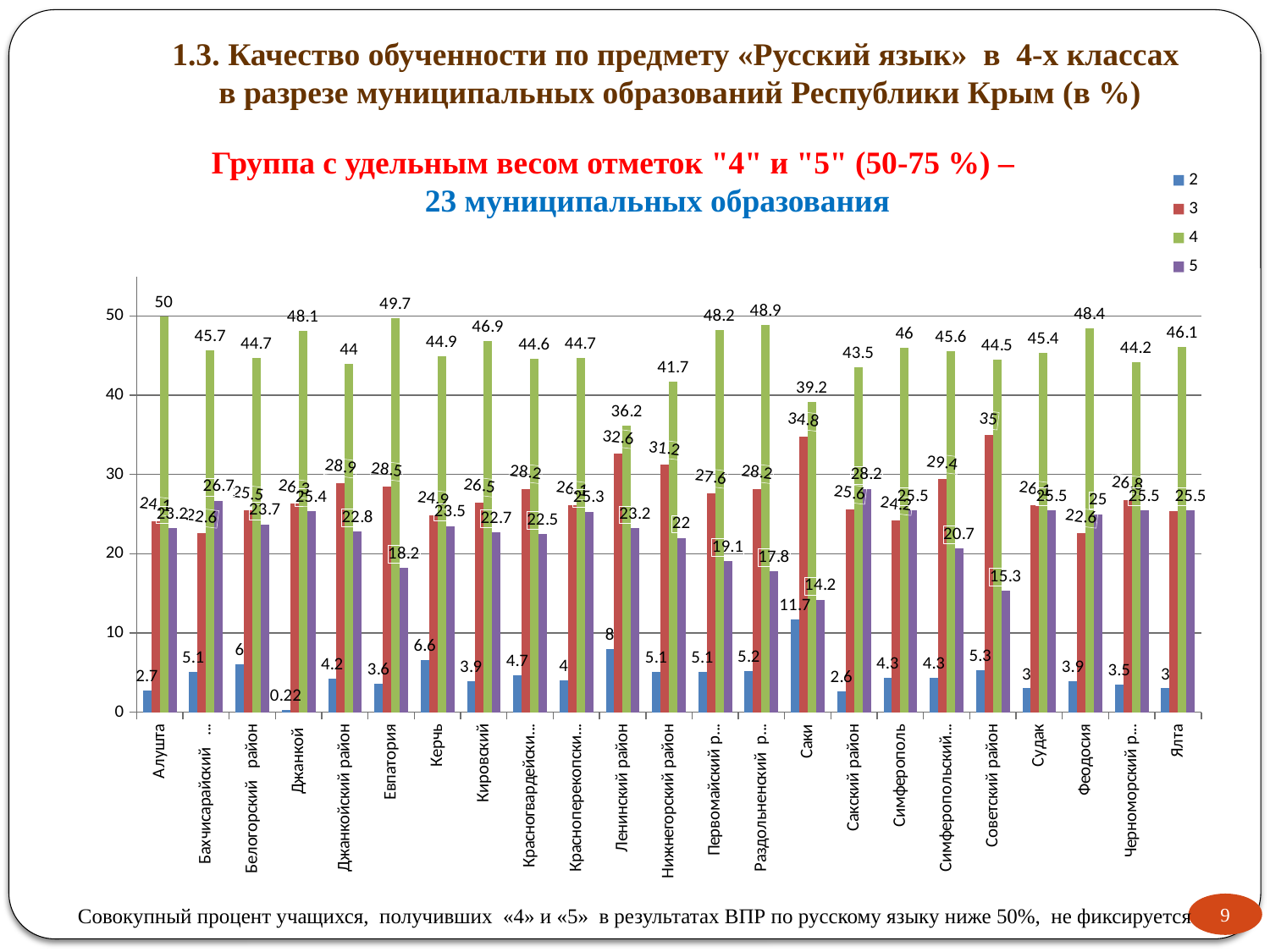
What is the difference between the series "4" values for Евпатория and Саки? 10.5 What is the value of series "2" for Саки? 11.7 What kind of chart is shown on the slide? bar chart Which municipality has the lowest value for series "4"? Ленинский район How many municipalities (categories) are shown on the x axis? 23 For Саки, which is larger: the value of series "3" or series "5"? series "3" How many series does the legend list? 4 What is the value of series "4" for Алушта? 50 What is the value of series "3" for Советский район? 35 Which municipality has the highest value for series "4"? Алушта Is the value of series "4" for Нижнегорский район greater or less than 40? greater Which municipality has the lowest value for series "2"? Джанкой